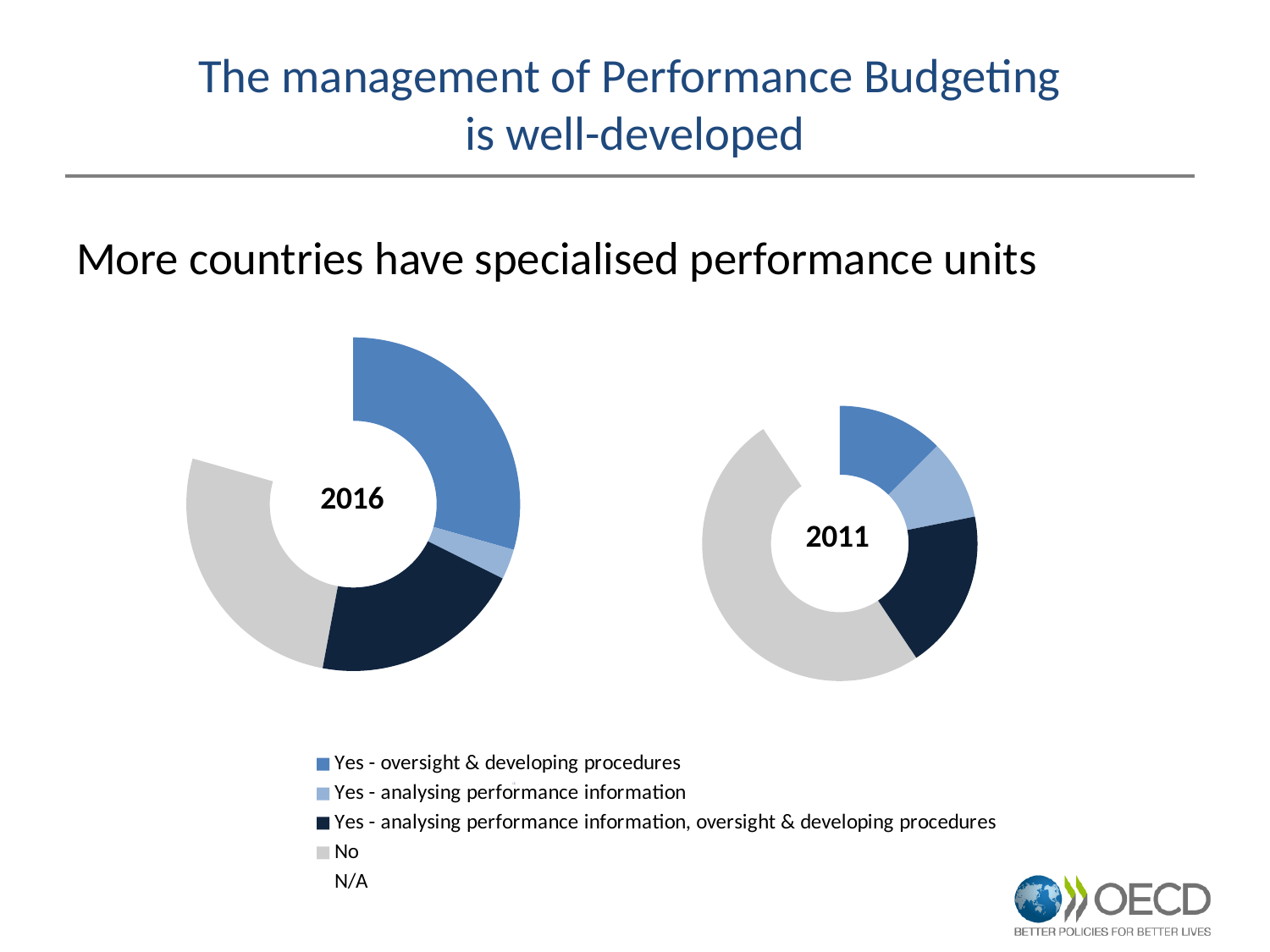
What is the title of the slide? The management of Performance Budgeting is well-developed How many doughnut charts are shown on the slide? 2 How many entries does the legend list? 5 In the 2016 chart, which coloured category has the smallest slice? Yes - analysing performance information In the 2011 chart, which category has the largest slice? No Which years are labelled in the centres of the two doughnut charts? 2016 and 2011 Is the 'No' share larger in the 2011 chart or the 2016 chart? 2011 What kind of chart is used to show the 2016 and 2011 data on this slide? Doughnut (pie) chart In the 2011 chart, which is larger: the 'No' slice or the 'Yes - analysing performance information, oversight & developing procedures' slice? No In the 2016 chart, which is larger: the 'Yes - oversight & developing procedures' slice or the 'Yes - analysing performance information' slice? Yes - oversight & developing procedures